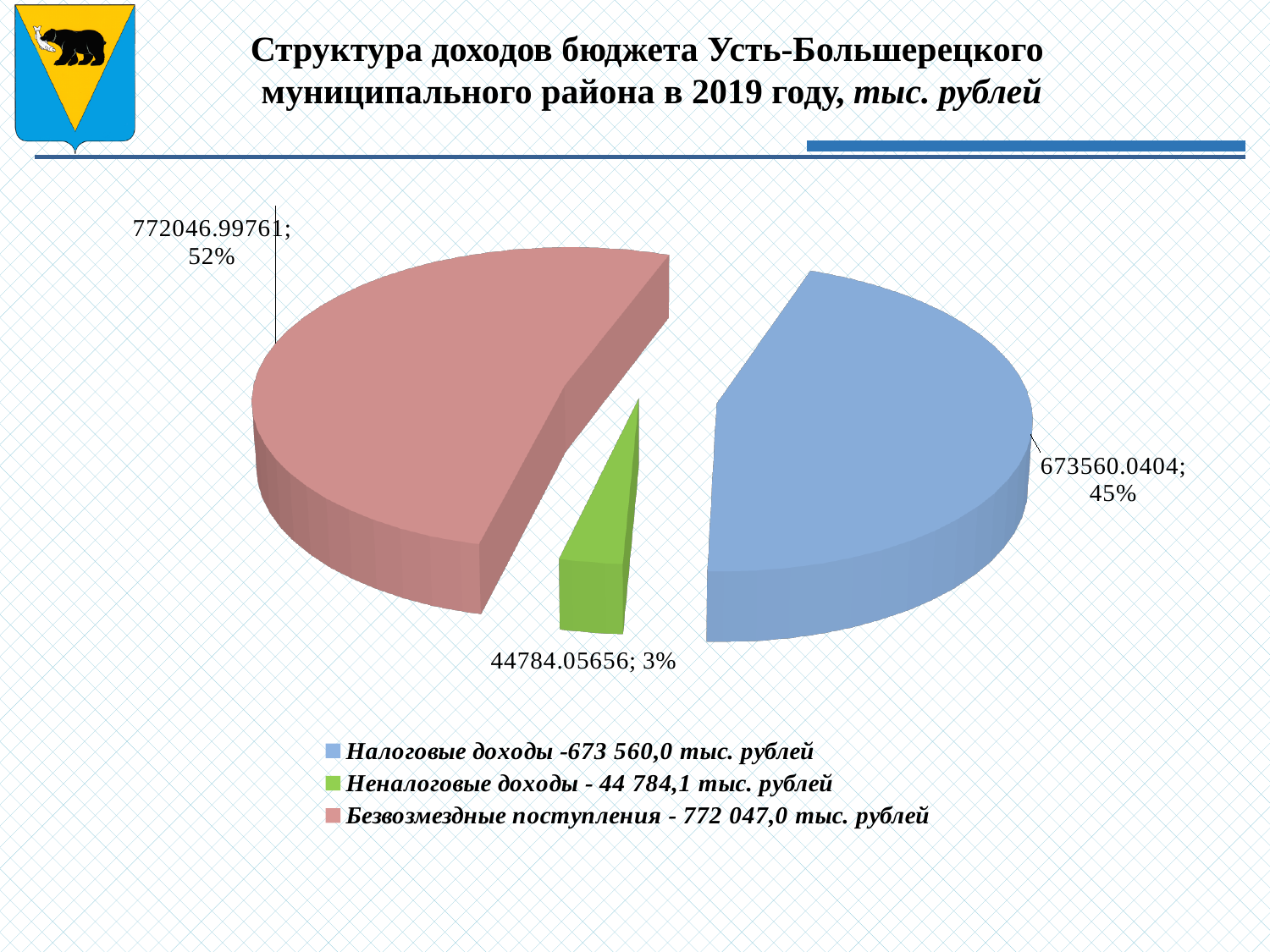
What kind of chart is shown on the slide? pie chart What value is shown on the data label for the Неналоговые доходы slice? 44784.05656 Which colour represents Неналоговые доходы in the pie chart? green What value is shown on the data label for the Налоговые доходы slice? 673560.0404 What share of the pie does the Неналоговые доходы slice represent? 3% What value is shown on the data label for the Безвозмездные поступления slice? 772046.99761 Which category has the largest slice of the pie? Безвозмездные поступления What share of the pie does the Безвозмездные поступления slice represent? 52% What share of the pie does the Налоговые доходы slice represent? 45% How many slices does the pie chart have? 3 How many entries does the legend list? 3 Which category has the smallest slice of the pie? Неналоговые доходы